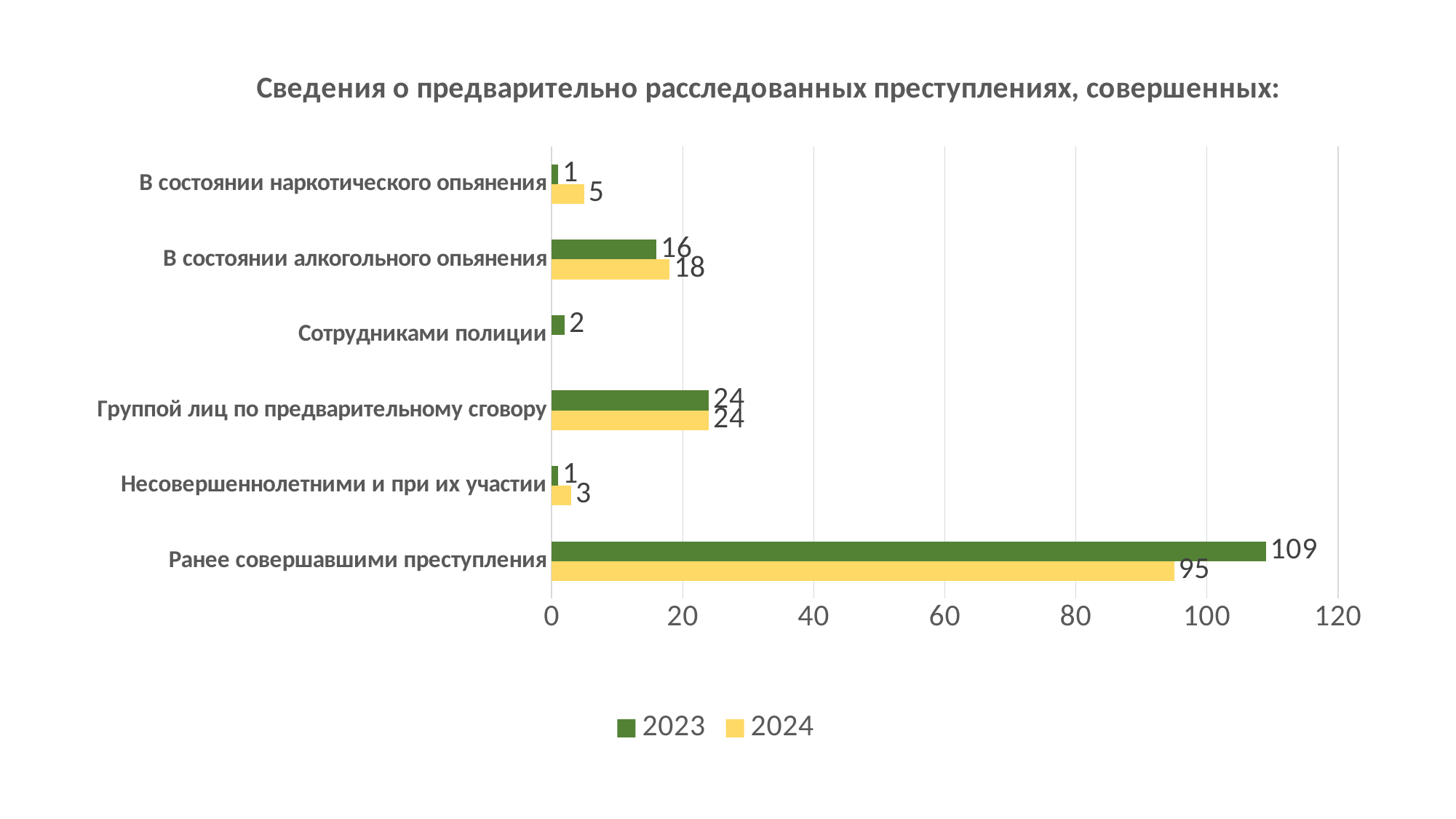
What is the 2024 value for "В состоянии наркотического опьянения"? 5 How many categories are shown on the chart? 6 What is the 2023 value for "Ранее совершавшими преступления"? 109 What is the 2023 value for "Сотрудниками полиции"? 2 How many series does the legend list? 2 Which category has the lowest 2024 value among those with a 2024 bar? Несовершеннолетними и при их участии What is the difference between the 2023 and 2024 values for "Ранее совершавшими преступления"? 14 What kind of chart is shown on the slide? bar chart Which is larger for "В состоянии алкогольного опьянения": the 2023 value or the 2024 value? 2024 What is the 2024 value for "В состоянии алкогольного опьянения"? 18 Is the 2024 value for "Ранее совершавшими преступления" greater or less than 100? less Which category has the highest 2024 value? Ранее совершавшими преступления